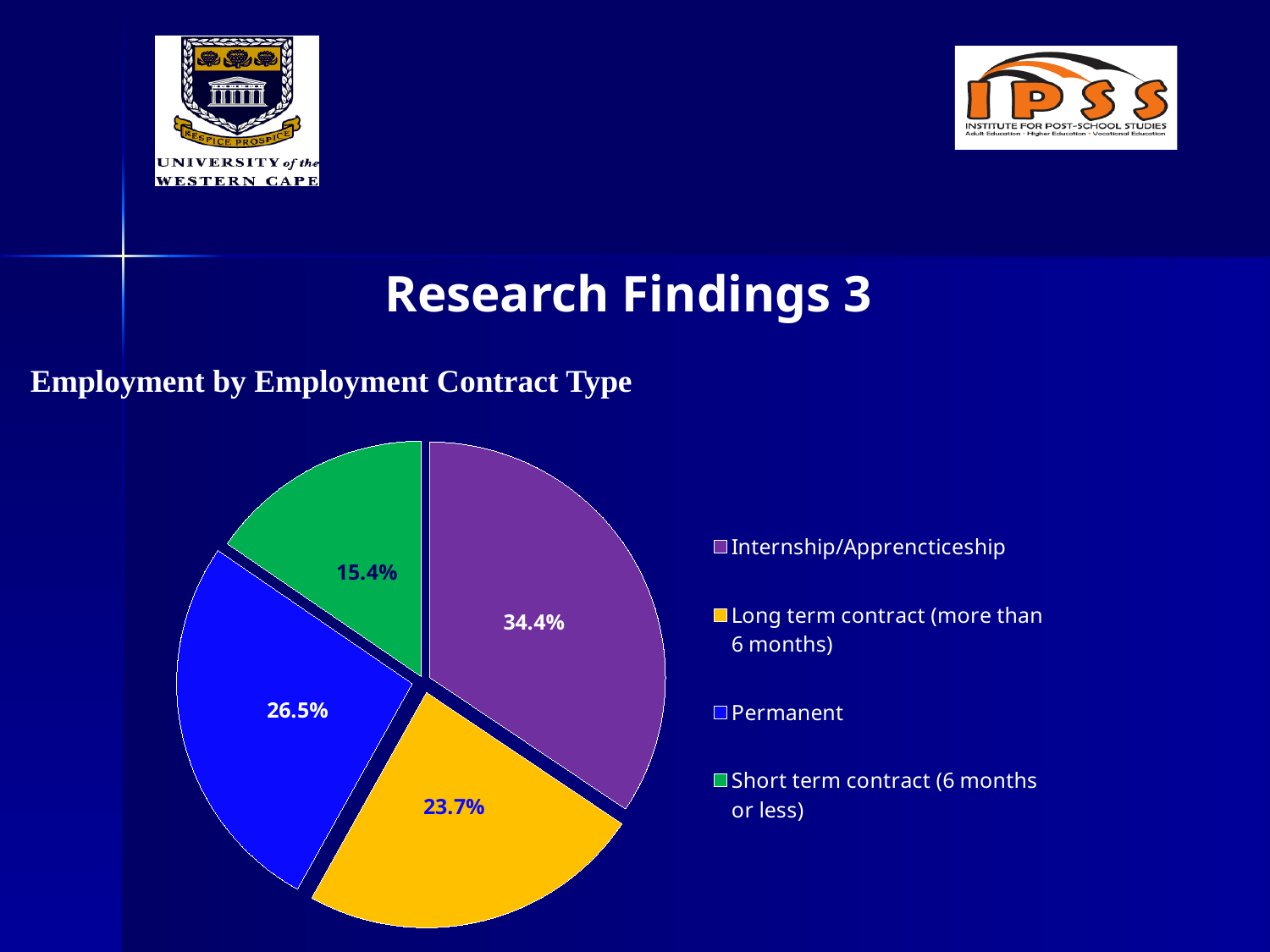
What is the title of the chart? Employment by Employment Contract Type Which employment contract type has the largest share? Internship/Apprencticeship What percentage of employment is Long term contract (more than 6 months)? 23.7% What percentage of employment is Permanent? 26.5% What type of chart is shown on the slide? pie chart What is the difference in percentage points between Internship/Apprencticeship and Permanent? 7.9 Which is larger, the share for Permanent or the share for Long term contract (more than 6 months)? Permanent What percentage of employment is Internship/Apprencticeship? 34.4% How many employment contract types are shown in the pie chart? 4 What percentage of employment is Short term contract (6 months or less)? 15.4% What colour is the Permanent slice in the pie chart? blue Which employment contract type has the smallest share? Short term contract (6 months or less)